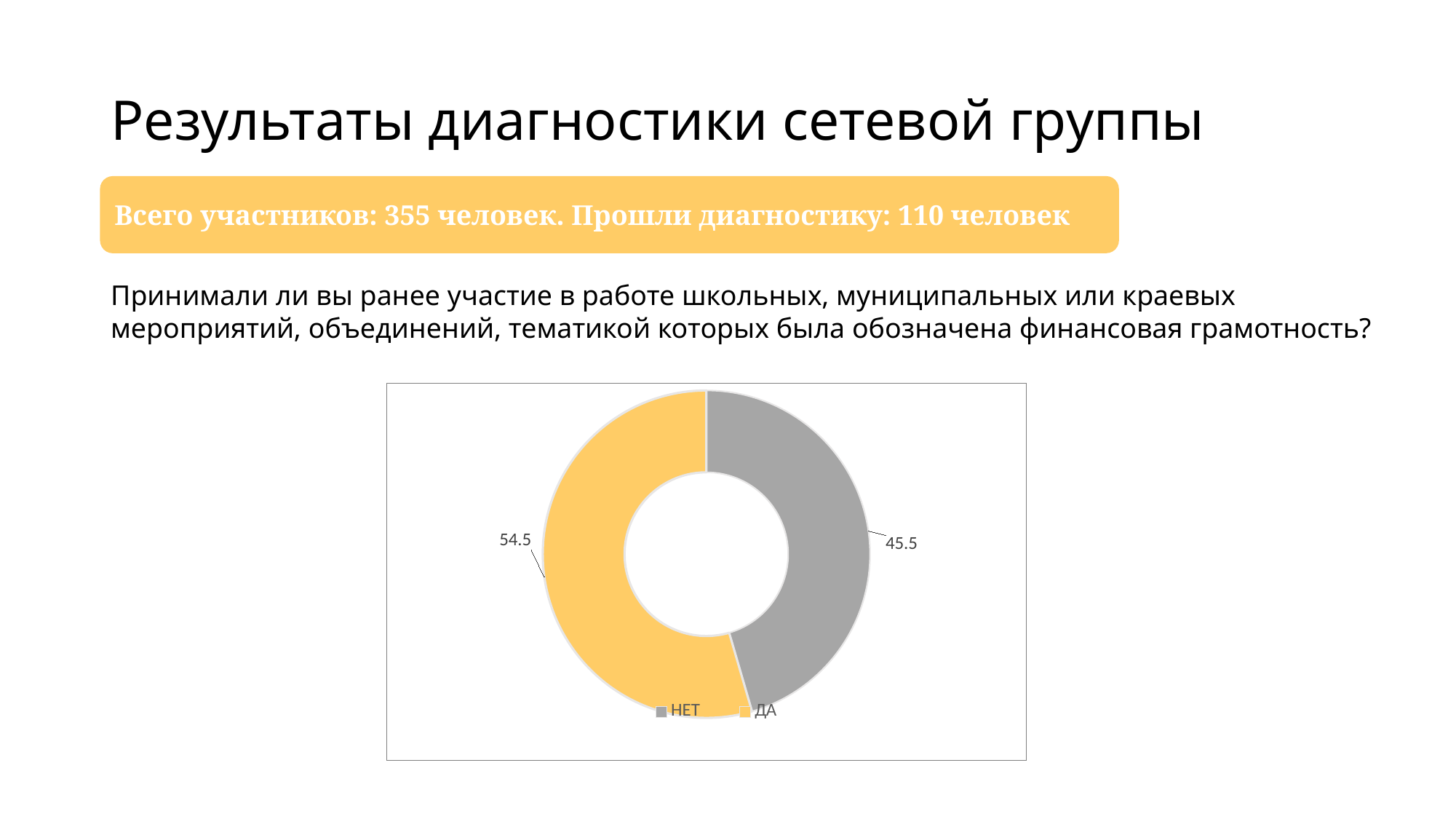
What colour is the ДА slice in the chart? yellow What is the total of the two values shown in the chart? 100 What colour is the НЕТ slice in the chart? grey How many categories does the chart show? 2 Which is larger, the value for ДА or the value for НЕТ? ДА Which category has the largest slice in the chart? ДА What kind of chart is shown on the slide? doughnut chart How many entries does the chart legend list? 2 Which category has the smallest slice in the chart? НЕТ What is the difference between the values for ДА and НЕТ? 9 What is the value for НЕТ in the chart? 45.5 What is the value for ДА in the chart? 54.5